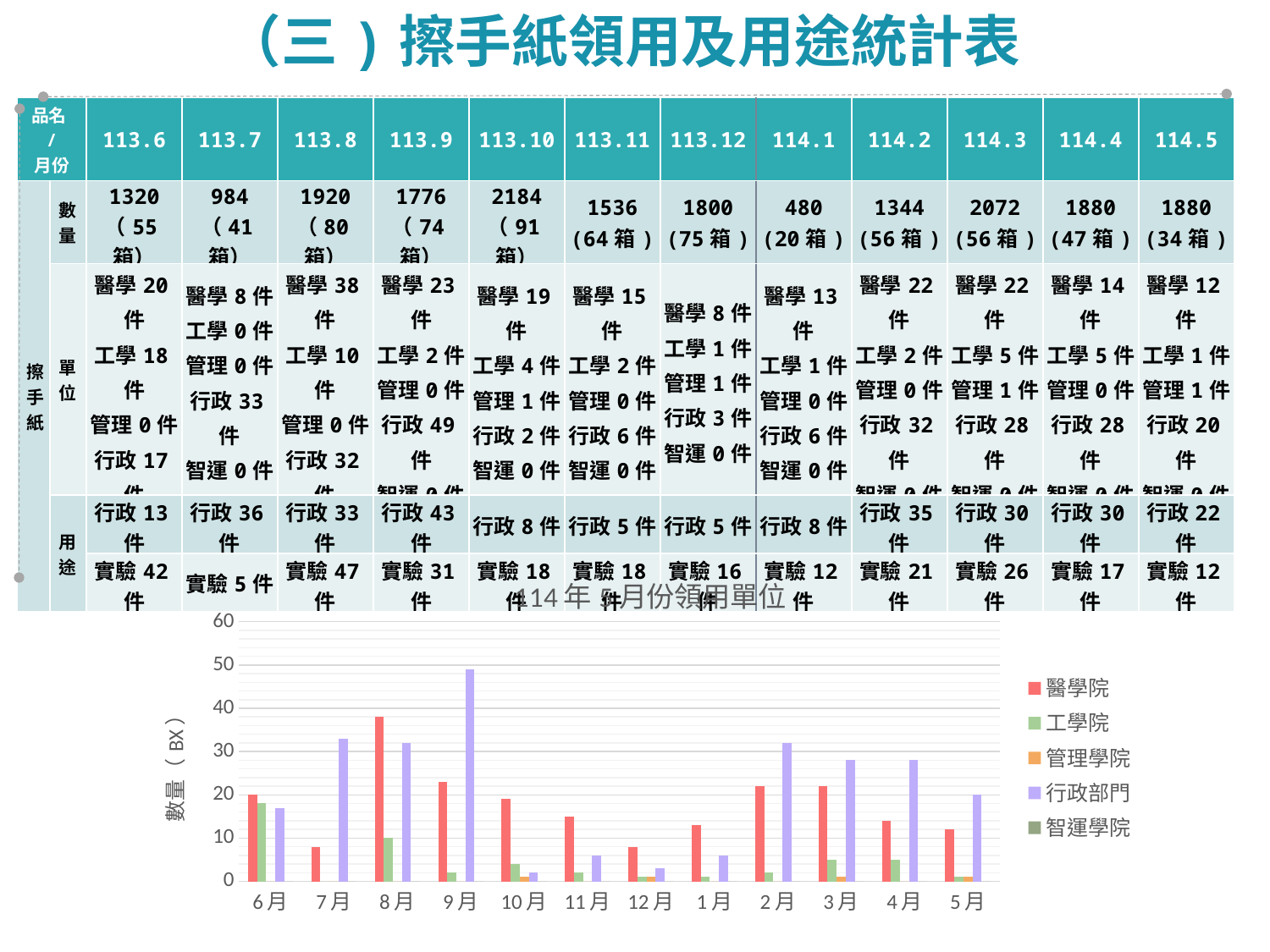
What kind of chart is shown at the bottom of the slide? bar chart Is the value for 醫學院 in 8月 greater or less than 30? greater In which month is the 行政部門 bar highest? 9月 How many months are shown along the x axis of the chart? 12 Is the value for 醫學院 in 7月 greater or less than 10? less Is the value for 行政部門 in 9月 greater or less than 40? greater How many series does the chart's legend list? 5 In which month is the 醫學院 bar highest? 8月 In 9月, which is larger: the 醫學院 bar or the 行政部門 bar? 行政部門 In 8月, which is larger: the 醫學院 bar or the 行政部門 bar? 醫學院 What is the label on the chart's vertical axis? 數量（BX）